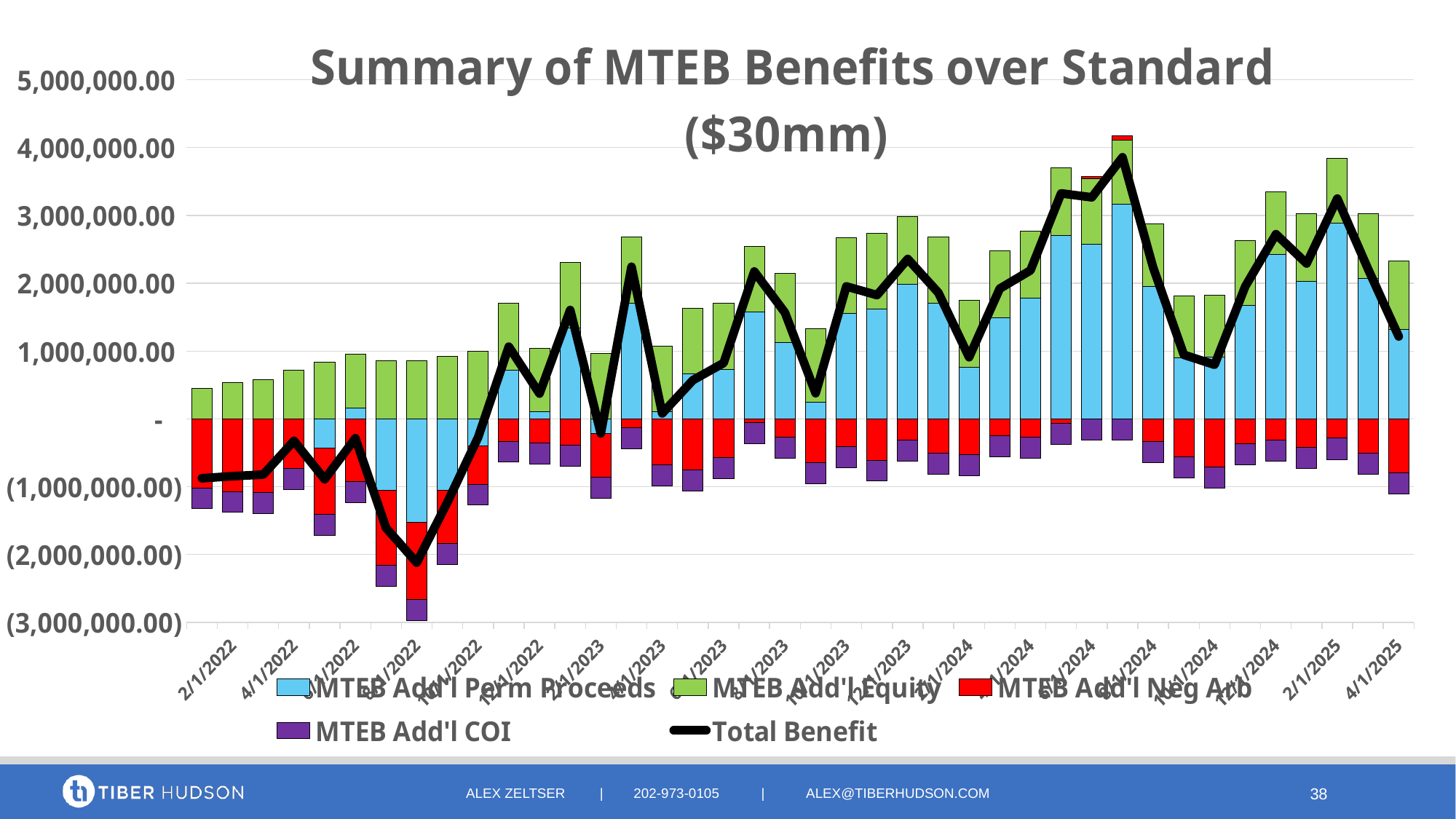
Which series is plotted as the black line? Total Benefit Which has the larger Total Benefit, 2/1/2022 or 4/1/2025? 4/1/2025 Is the Total Benefit value for 2/1/2022 greater or less than 0? less Does the Total Benefit line generally rise or fall from 2/1/2022 to 2/1/2025? rise Is the Total Benefit value for 4/1/2025 greater or less than 1,000,000.00? greater What kind of chart is shown on the slide? Stacked bar chart with a line Is the Total Benefit value for 2/1/2025 greater or less than 3,000,000.00? greater What is the title of the chart? Summary of MTEB Benefits over Standard ($30mm) How many series does the legend list? 5 Which has the larger Total Benefit, 2/1/2025 or 4/1/2025? 2/1/2025